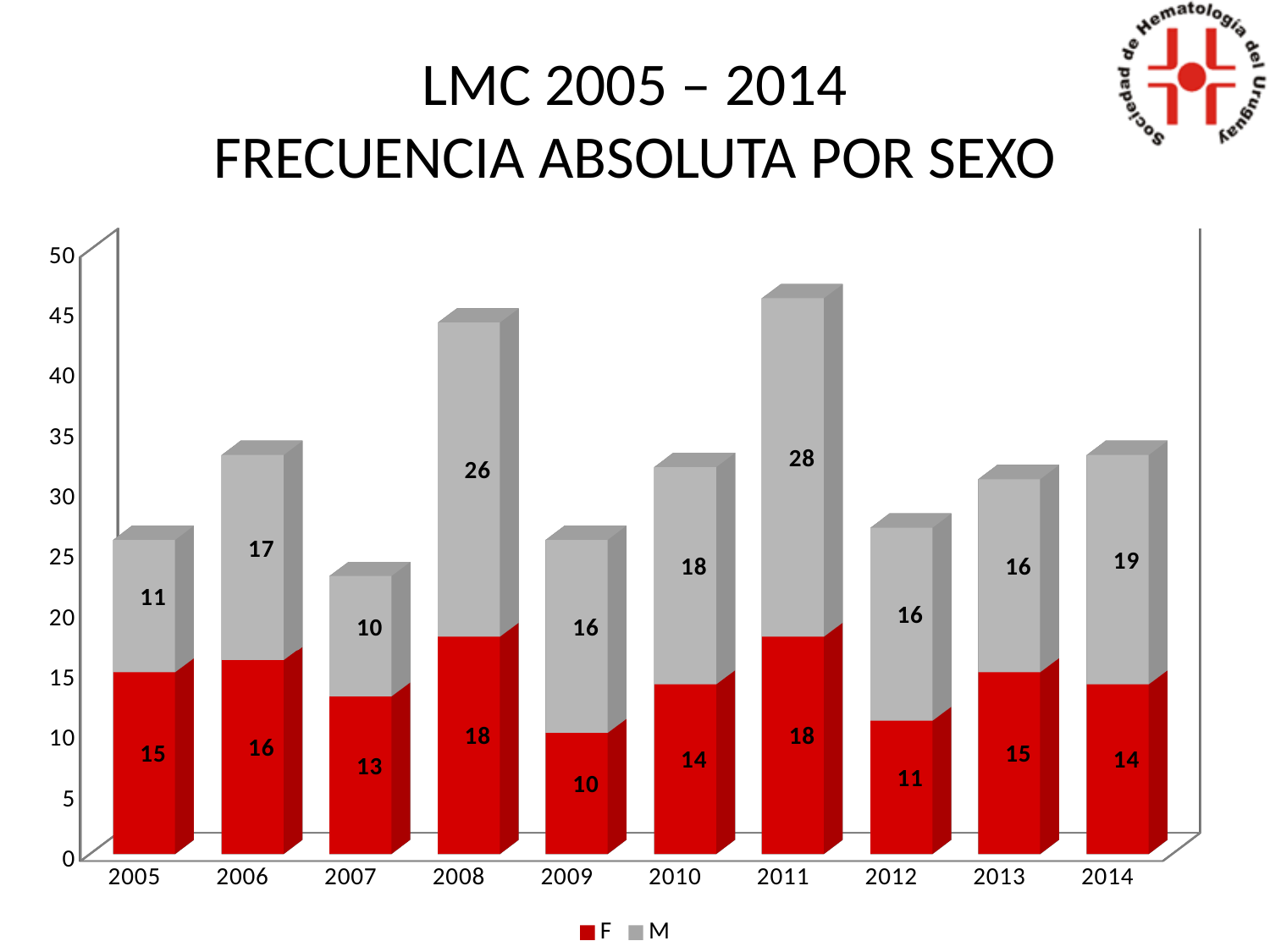
How many years are shown on the x axis? 10 What is the total of the stacked bar for 2011? 46 What is the total of the stacked bar for 2007? 23 What is the difference between the M value and the F value in 2008? 8 What is the value for M in 2007? 10 Which is larger in 2005, the value for F or the value for M? F What kind of chart is shown on the slide? Stacked bar chart What is the value for F in 2008? 18 Which year has the highest value for M? 2011 Which year has the lowest value for F? 2009 What is the value for M in 2011? 28 How many series does the legend list? 2